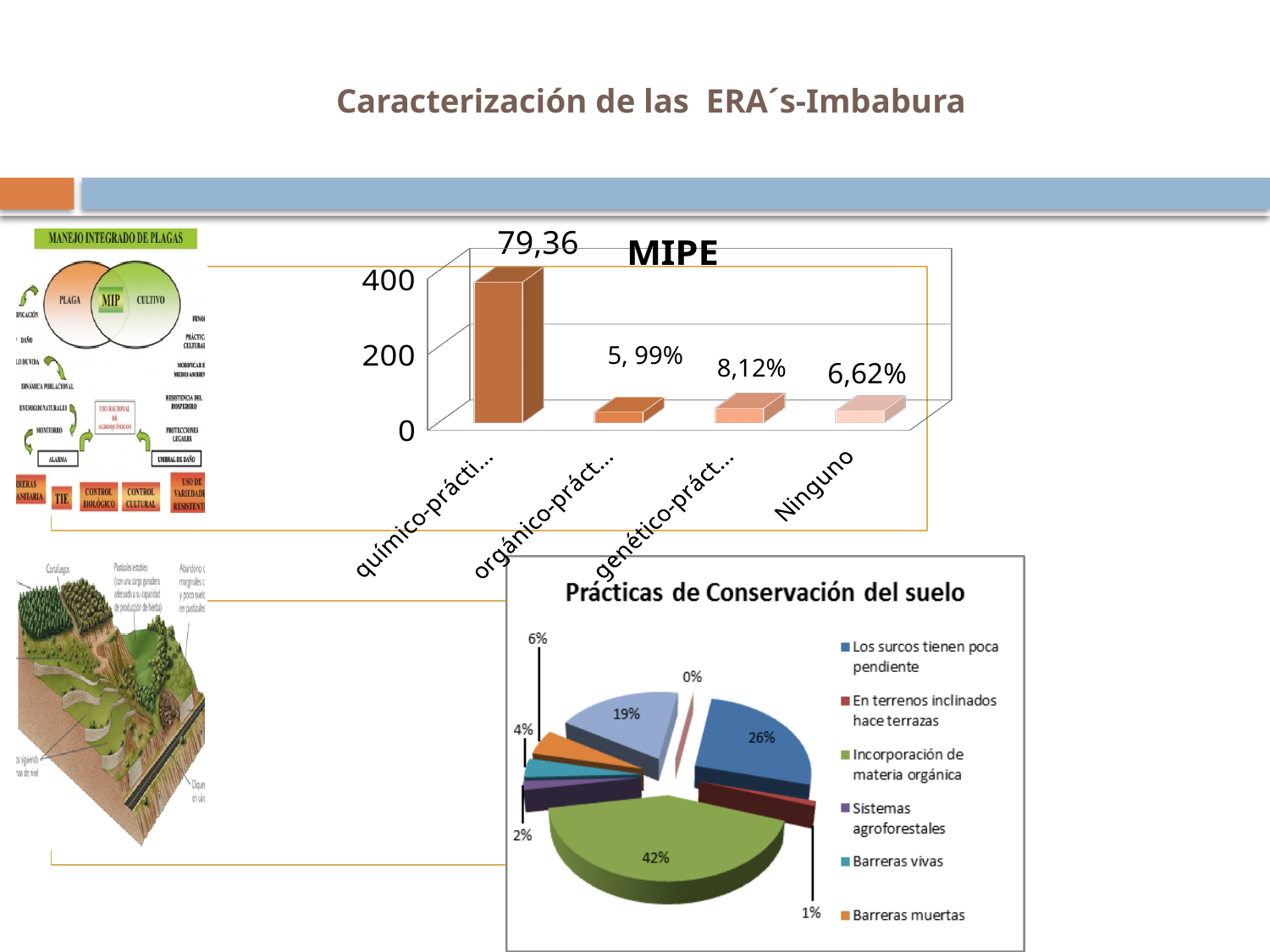
In the 'Prácticas de Conservación del suelo' pie chart, what is the difference between the 42% slice and the 26% slice? 16% In the 'Prácticas de Conservación del suelo' pie chart, what is the largest slice's percentage? 42% In the 'Prácticas de Conservación del suelo' pie chart, what percentage is shown for 'Incorporación de materia orgánica' (the green slice)? 42% What kind of chart is the MIPE chart? bar chart In the MIPE chart, how many categories are shown on the x axis? 4 In the MIPE chart, is the bar for 'Ninguno' taller or shorter than the bar for the 'genético' category? shorter In the MIPE chart, what value is labelled on the bar for the 'químico' category? 79,36 In the MIPE chart, which category has the tallest bar? químico-prácti... In the MIPE chart, what value is labelled on the bar for the 'genético' category? 8,12% In the MIPE chart, what value is labelled on the bar for 'Ninguno'? 6,62% What kind of chart is the 'Prácticas de Conservación del suelo' chart? pie chart In the 'Prácticas de Conservación del suelo' pie chart, what percentage is shown for 'Los surcos tienen poca pendiente' (the blue slice)? 26%